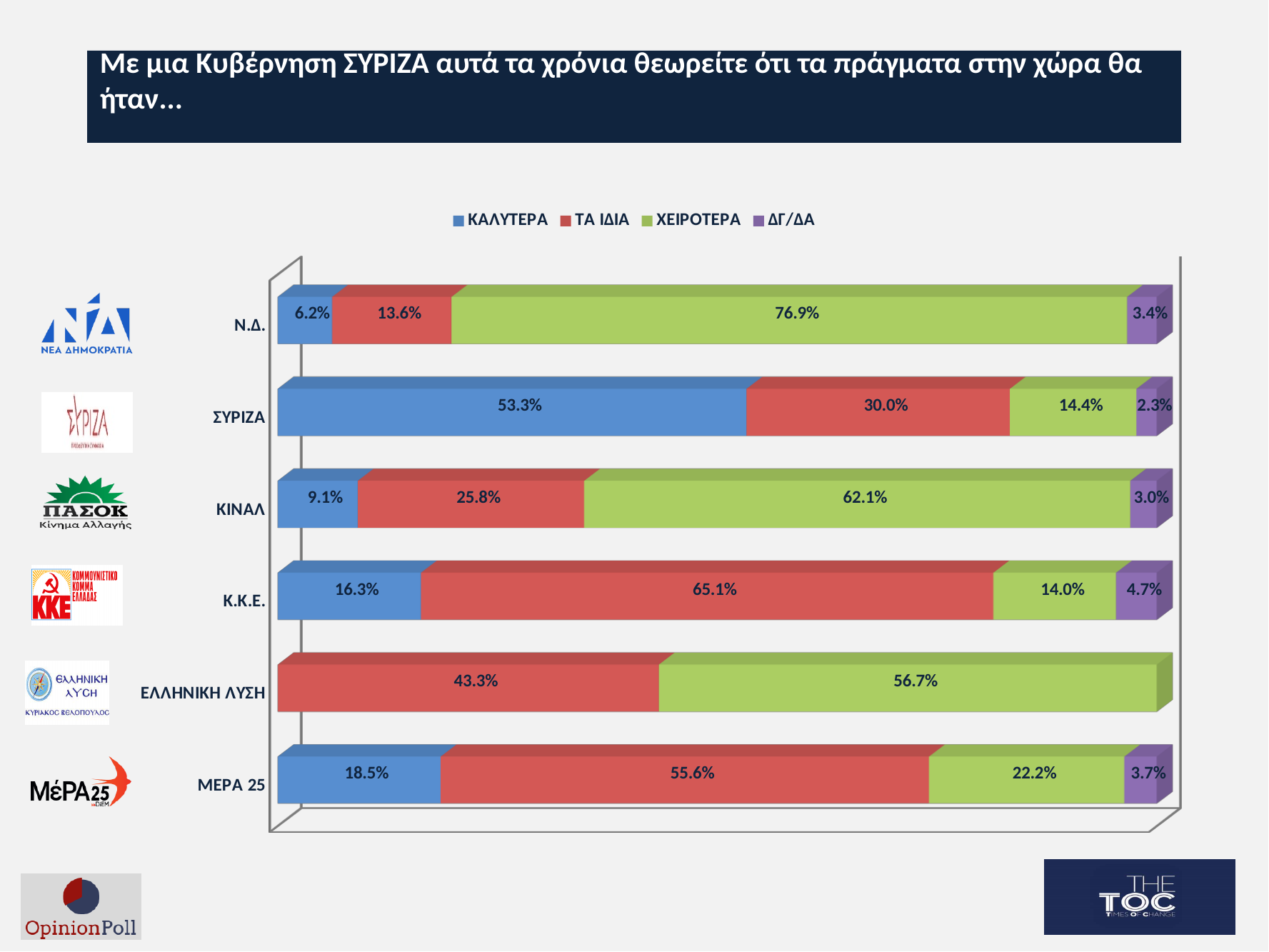
Which party has the lowest ΧΕΙΡΟΤΕΡΑ value? Κ.Κ.Ε. Which is larger: the ΤΑ ΙΔΙΑ value for ΕΛΛΗΝΙΚΗ ΛΥΣΗ or for ΜΕΡΑ 25? ΜΕΡΑ 25 What percentage of Ν.Δ. voters answered ΧΕΙΡΟΤΕΡΑ? 76.9% How many parties are shown on the chart? 6 What is the ΔΓ/ΔΑ value for ΜΕΡΑ 25? 3.7% What kind of chart is shown on the slide? Stacked bar chart What is the ΚΑΛΥΤΕΡΑ value for ΣΥΡΙΖΑ? 53.3% What is the ΤΑ ΙΔΙΑ value for Κ.Κ.Ε.? 65.1% How many series does the legend list? 4 What is the difference between the ΧΕΙΡΟΤΕΡΑ values for Ν.Δ. and ΚΙΝΑΛ? 14.8% Which colour represents ΧΕΙΡΟΤΕΡΑ in the legend? Green Which party has the highest ΚΑΛΥΤΕΡΑ value? ΣΥΡΙΖΑ